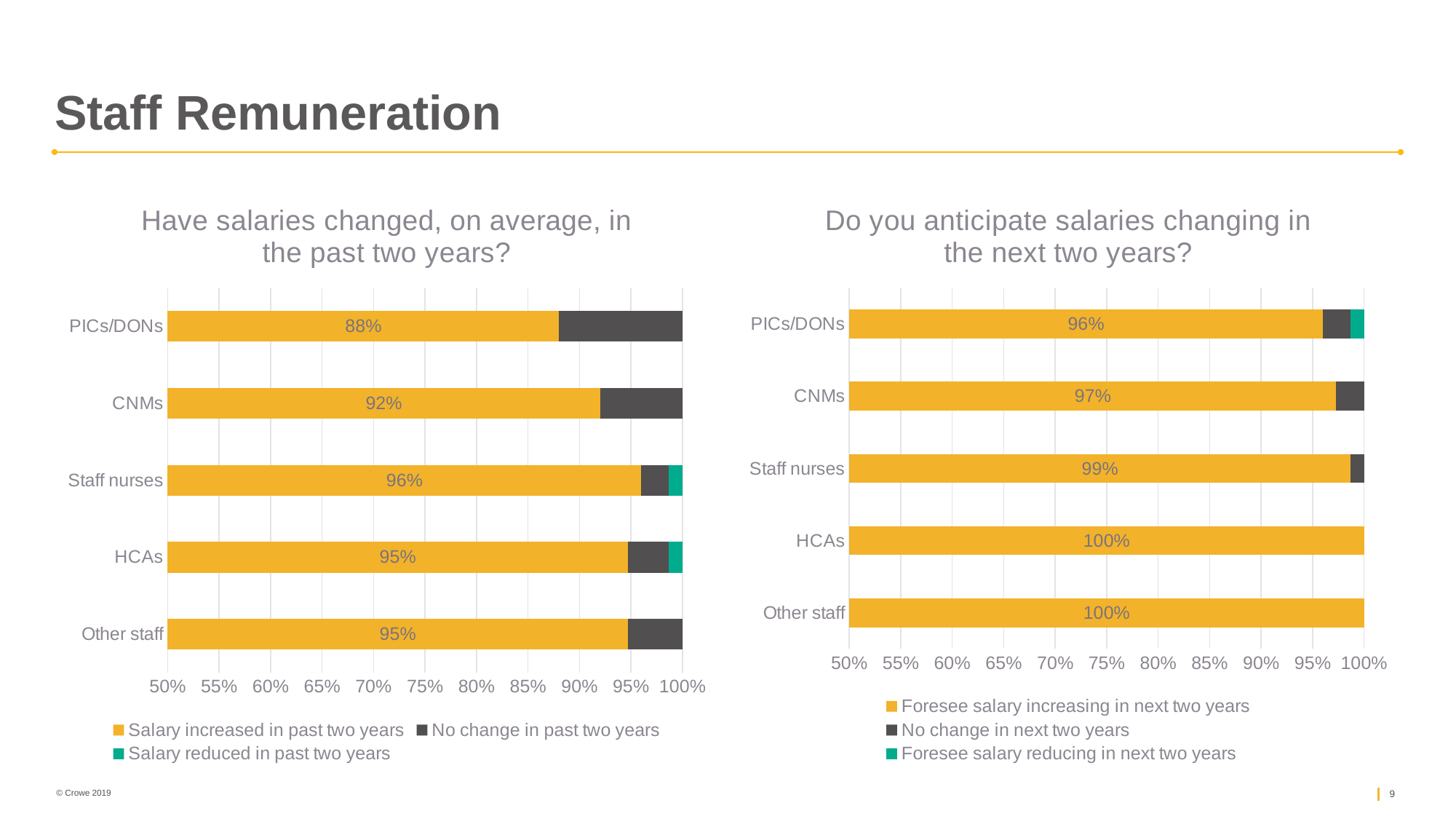
In the chart 'Have salaries changed, on average, in the past two years?', which category has the highest percentage for salary increased in past two years? Staff nurses In the chart 'Have salaries changed, on average, in the past two years?', what percentage of PICs/DONs had salary increased in the past two years? 88% How many categories are shown in the chart 'Have salaries changed, on average, in the past two years?'? 5 In the chart 'Have salaries changed, on average, in the past two years?', which category has the lowest percentage for salary increased in past two years? PICs/DONs In the chart 'Do you anticipate salaries changing in the next two years?', what is the value for HCAs for foresee salary increasing in next two years? 100% In the chart 'Have salaries changed, on average, in the past two years?', what is the value for CNMs for salary increased in past two years? 92% How many series does the legend list in the chart 'Do you anticipate salaries changing in the next two years?'? 3 In the chart 'Have salaries changed, on average, in the past two years?', what is the difference between the salary increased percentages for Staff nurses and PICs/DONs? 8% In the chart 'Do you anticipate salaries changing in the next two years?', what percentage of Staff nurses foresee salary increasing in the next two years? 99% In the chart 'Do you anticipate salaries changing in the next two years?', which category has the lowest percentage for foresee salary increasing in next two years? PICs/DONs What type of chart is 'Have salaries changed, on average, in the past two years?'? Stacked bar chart In the chart 'Do you anticipate salaries changing in the next two years?', which is larger: the foresee salary increasing value for CNMs or for PICs/DONs? CNMs